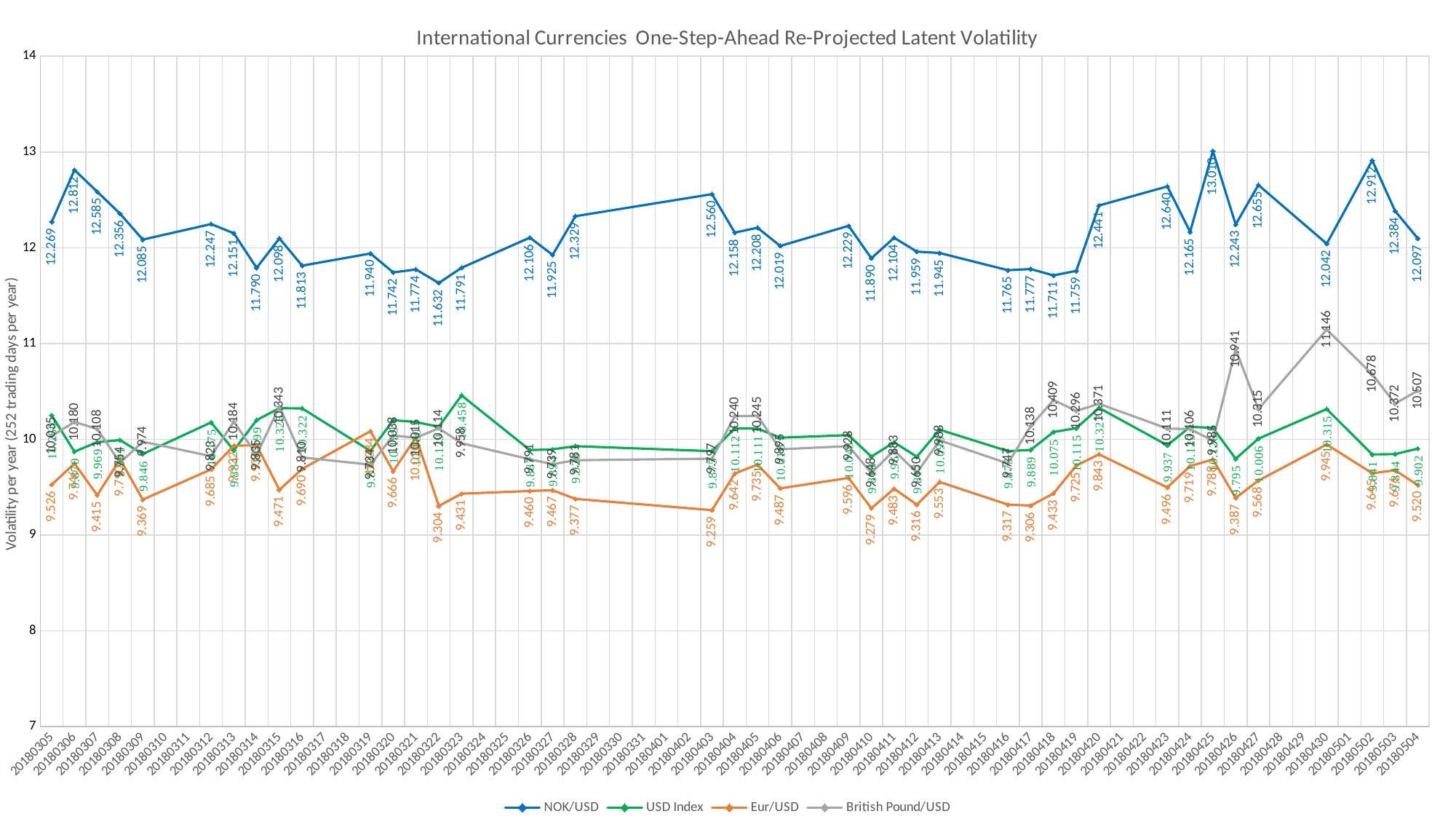
What is the NOK/USD value on 20180425? 13.010 On which date does NOK/USD reach its highest value? 20180425 Which series has the higher value on 20180430, British Pound/USD or USD Index? British Pound/USD How many series does the legend list? 4 What is the difference between the highest NOK/USD value (20180425) and the lowest NOK/USD value (20180322)? 1.378 On which date does NOK/USD reach its lowest value? 20180322 What is the Eur/USD value on 20180403? 9.259 What is the British Pound/USD value on 20180430? 11.146 What kind of chart is shown on the slide? line chart Which series is plotted in orange? Eur/USD What is the title of the chart? International Currencies One-Step-Ahead Re-Projected Latent Volatility Is the NOK/USD value on 20180322 greater or less than 11? greater